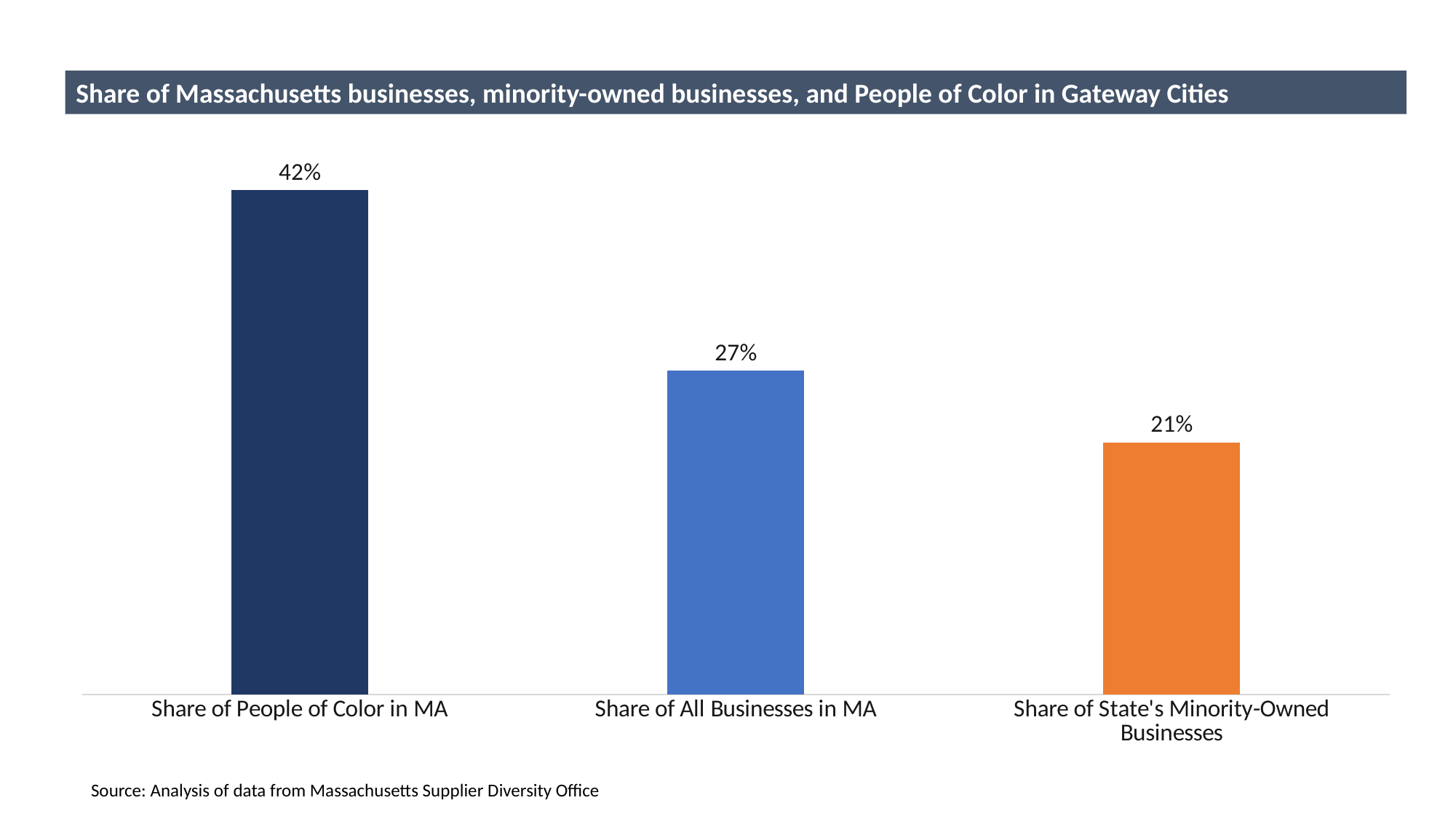
What is the difference between Share of People of Color in MA and Share of All Businesses in MA? 15% What kind of chart is shown on the slide? Bar chart What is the value for Share of State's Minority-Owned Businesses? 21% Which category has the lowest value? Share of State's Minority-Owned Businesses Which is larger: Share of All Businesses in MA or Share of State's Minority-Owned Businesses? Share of All Businesses in MA Do the values rise or fall from left to right across the categories? Fall What is the value for Share of People of Color in MA? 42% What is the value for Share of All Businesses in MA? 27% What is the title of the chart? Share of Massachusetts businesses, minority-owned businesses, and People of Color in Gateway Cities What is the difference between Share of All Businesses in MA and Share of State's Minority-Owned Businesses? 6% Which category has the highest value? Share of People of Color in MA How many categories are shown in the chart? 3